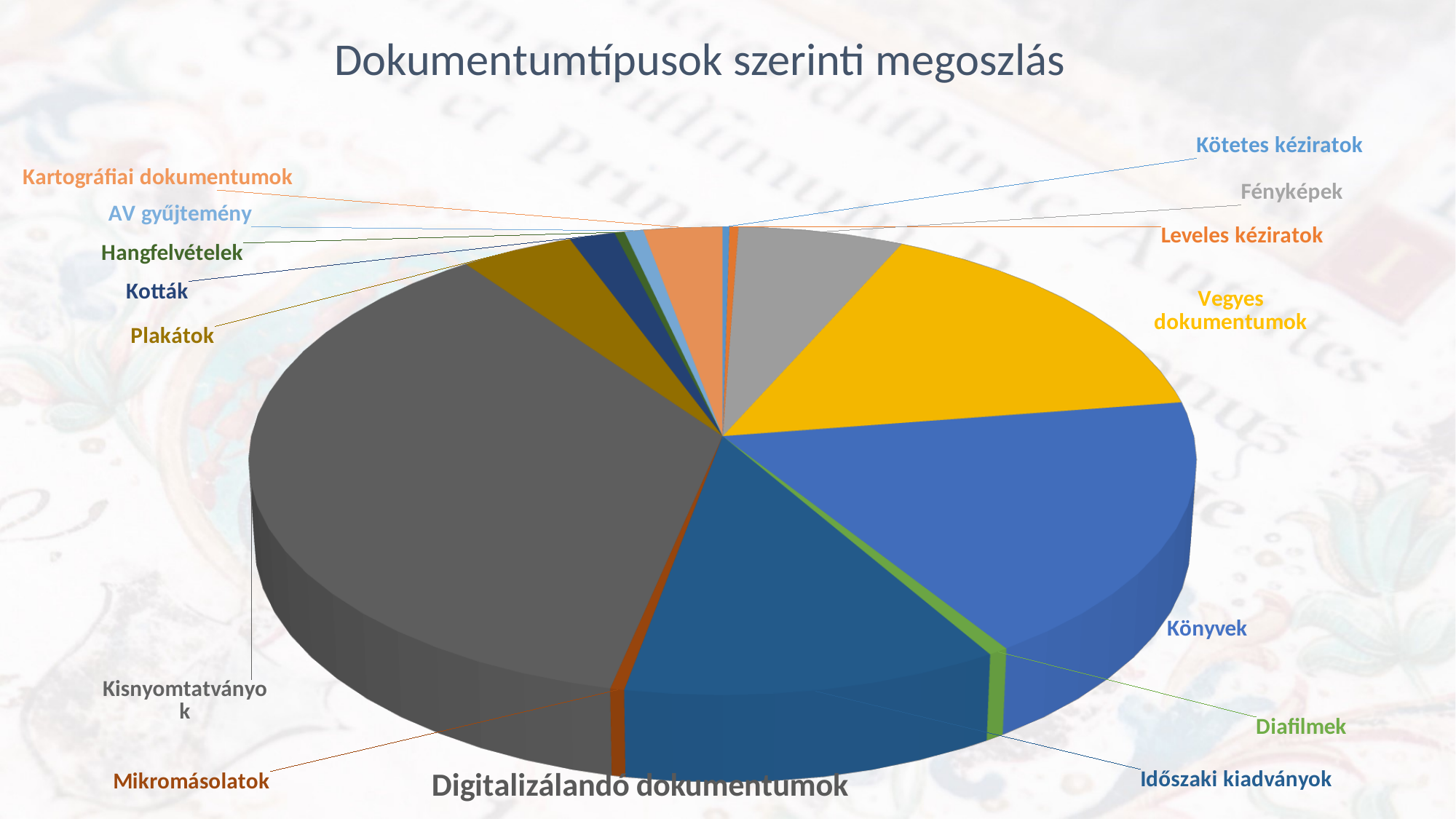
How many categories (slices) does the pie chart have? 14 What is the title of the chart? Digitalizálandó dokumentumok Which category has the largest slice of the pie? Kisnyomtatványok Which slice is larger, Vegyes dokumentumok or Plakátok? Vegyes dokumentumok Which slice is larger, Kisnyomtatványok or Könyvek? Kisnyomtatványok Which slice is larger, Fényképek or Hangfelvételek? Fényképek What kind of chart is shown on the slide? Pie chart